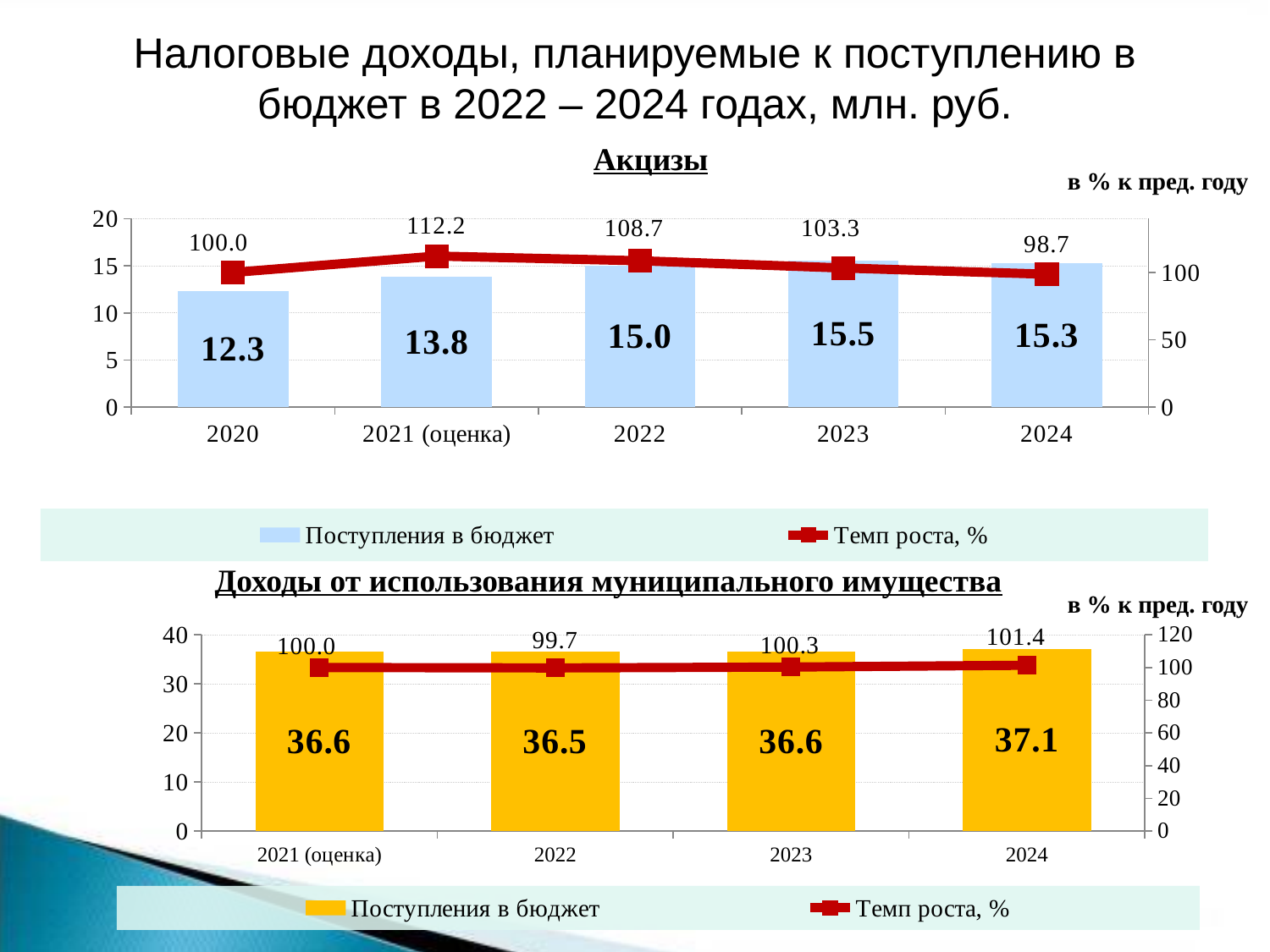
What colour are the bars in the 'Доходы от использования муниципального имущества' chart? Yellow In the 'Акцизы' chart, what is the difference between the 'Поступления в бюджет' values for 2023 and 2020? 3.2 In the 'Акцизы' chart, which year has the lowest 'Темп роста, %' value? 2024 In the 'Акцизы' chart, how many years are shown on the x axis? 5 In the 'Доходы от использования муниципального имущества' chart, which year has the lowest 'Поступления в бюджет' value? 2022 In the 'Доходы от использования муниципального имущества' chart, is the 'Темп роста, %' value for 2024 larger or smaller than the value for 2022? larger In the 'Акцизы' chart, how many series does the legend list? 2 In the 'Доходы от использования муниципального имущества' chart, what is the 'Темп роста, %' value for 2022? 99.7 In the 'Акцизы' chart, what is the 'Темп роста, %' value for 2021 (оценка)? 112.2 In the 'Акцизы' chart, what is the value of 'Поступления в бюджет' for 2022? 15.0 In the 'Доходы от использования муниципального имущества' chart, what is the 'Поступления в бюджет' value for 2024? 37.1 In the 'Акцизы' chart, which year has the highest 'Поступления в бюджет' value? 2023